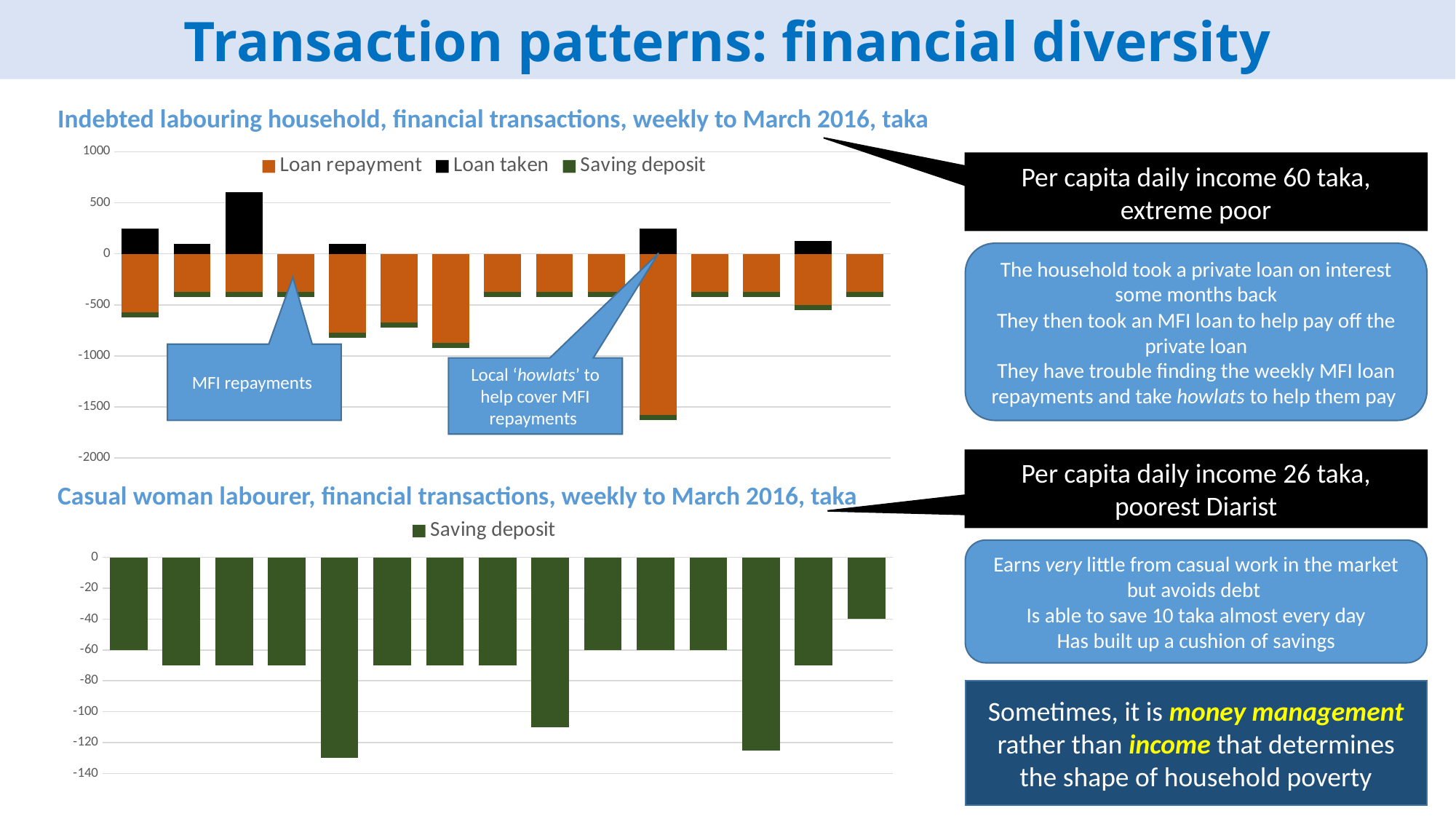
What kind of chart is the top chart, 'Indebted labouring household, financial transactions, weekly to March 2016, taka'? Stacked bar chart In the bottom chart (Casual woman labourer), what is the Saving deposit value of the last bar? -40 How many bars are plotted in the bottom chart (Casual woman labourer)? 15 How many weekly bars are plotted in the top chart (Indebted labouring household)? 15 What kind of chart is the bottom chart, 'Casual woman labourer, financial transactions, weekly to March 2016, taka'? Bar chart In the top chart (Indebted labouring household), is the Loan repayment value for the eleventh bar (the largest negative bar) greater or less than -1500? less How many series does the legend of the top chart (Indebted labouring household) list? 3 How many series does the legend of the bottom chart (Casual woman labourer) list? 1 In the top chart (Indebted labouring household), is the Loan taken value for the third bar greater or less than 500? greater What are the legend entries of the top chart (Indebted labouring household)? Loan repayment, Loan taken, Saving deposit In the bottom chart (Casual woman labourer), is the Saving deposit value of the fifth bar greater or less than -120? less In the top chart (Indebted labouring household), which series is shown in orange? Loan repayment